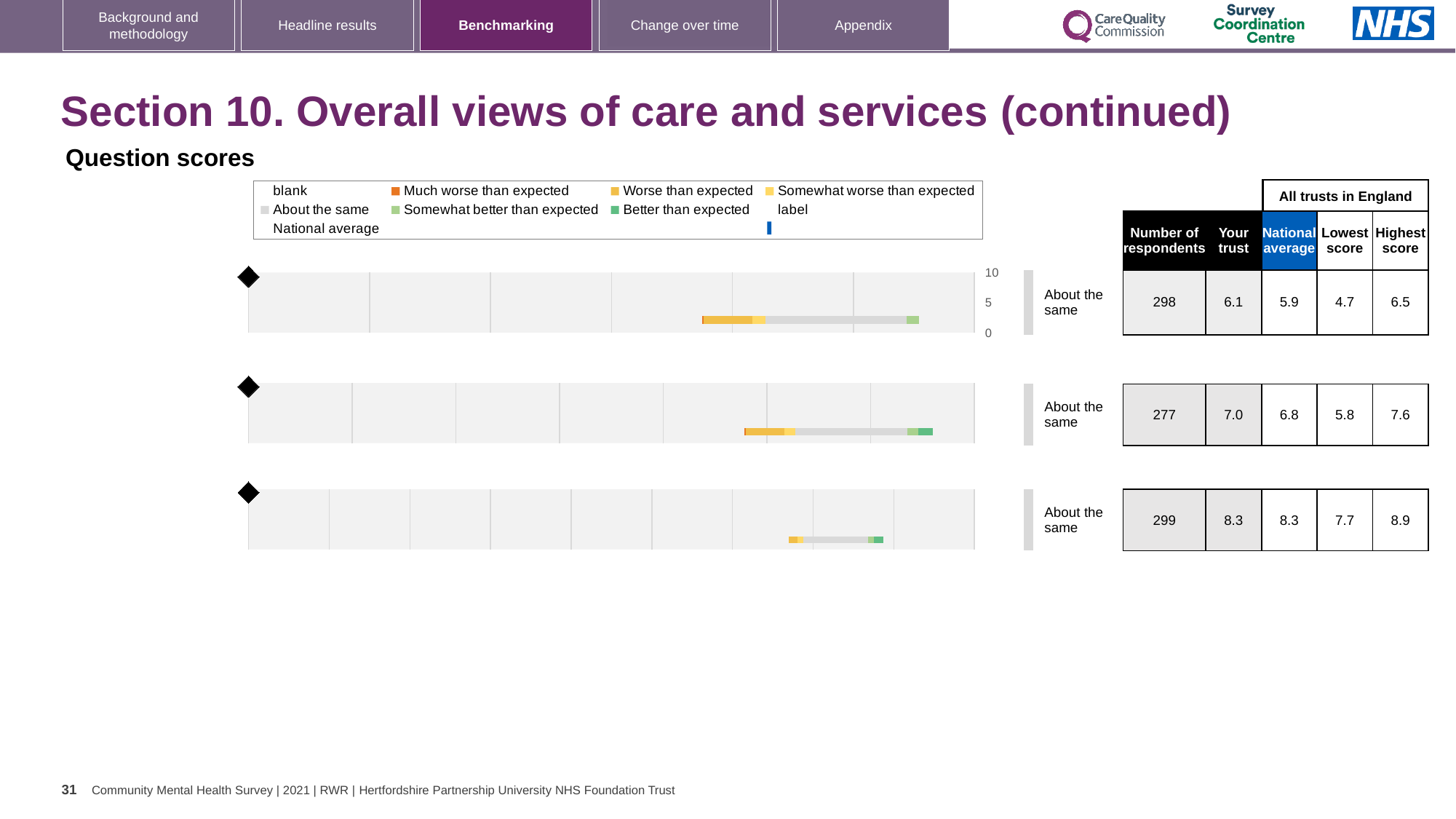
In the legend, what colour represents 'Much worse than expected'? orange Which of the three charts has the highest 'Your trust' score? the bottom chart For the top chart, what is the difference between the highest score (6.5) and the lowest score (4.7)? 1.8 For the top chart, what is the 'Your trust' score shown in the table? 6.1 For the middle chart, which is larger: the 'Your trust' score or the national average? Your trust For the middle chart, what is the difference between the 'Your trust' score and the national average? 0.2 For the bottom chart, how many respondents are listed in the table? 299 For the middle chart, what is the national average score shown in the table? 6.8 How many question score charts are shown on the slide? 3 What kind of chart is used to show the question scores on this slide? bar chart For the bottom chart, what is the lowest score among all trusts in England? 7.7 What benchmark category is shown next to each of the three charts? About the same